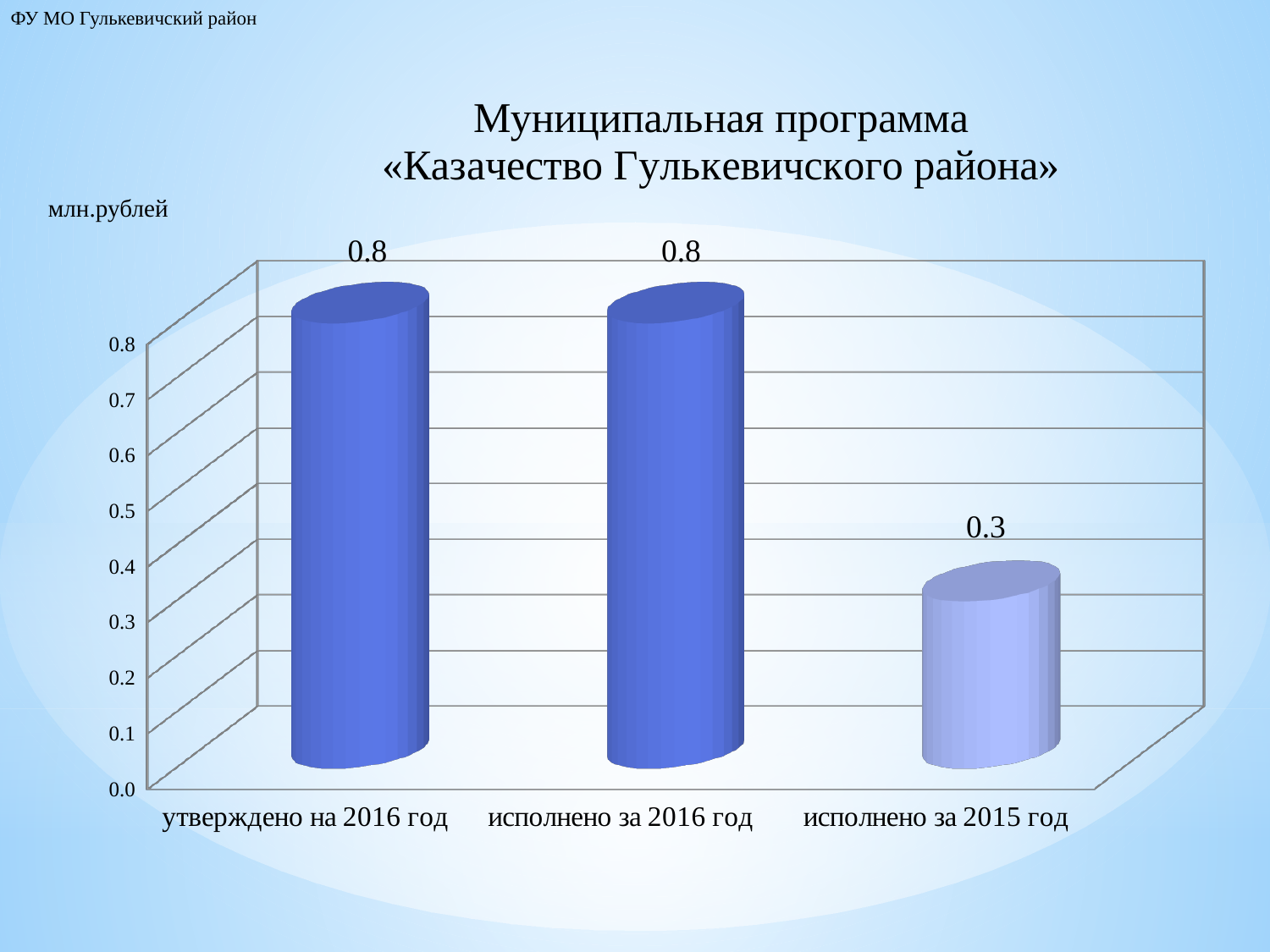
What is the value for «исполнено за 2015 год»? 0.3 What kind of chart is shown on the slide? bar chart What is the difference between the values for «исполнено за 2016 год» and «исполнено за 2015 год»? 0.5 What unit is indicated for the values on the chart? млн.рублей What is the value for «утверждено на 2016 год»? 0.8 What is the value for «исполнено за 2016 год»? 0.8 Is the value for «утверждено на 2016 год» greater or less than 0.5? greater What is the title of the chart? Муниципальная программа «Казачество Гулькевичского района» Which is larger: the value for «утверждено на 2016 год» or the value for «исполнено за 2015 год»? утверждено на 2016 год Which category has the lowest value? исполнено за 2015 год Is the value for «исполнено за 2015 год» greater or less than 0.5? less How many categories are shown on the chart? 3